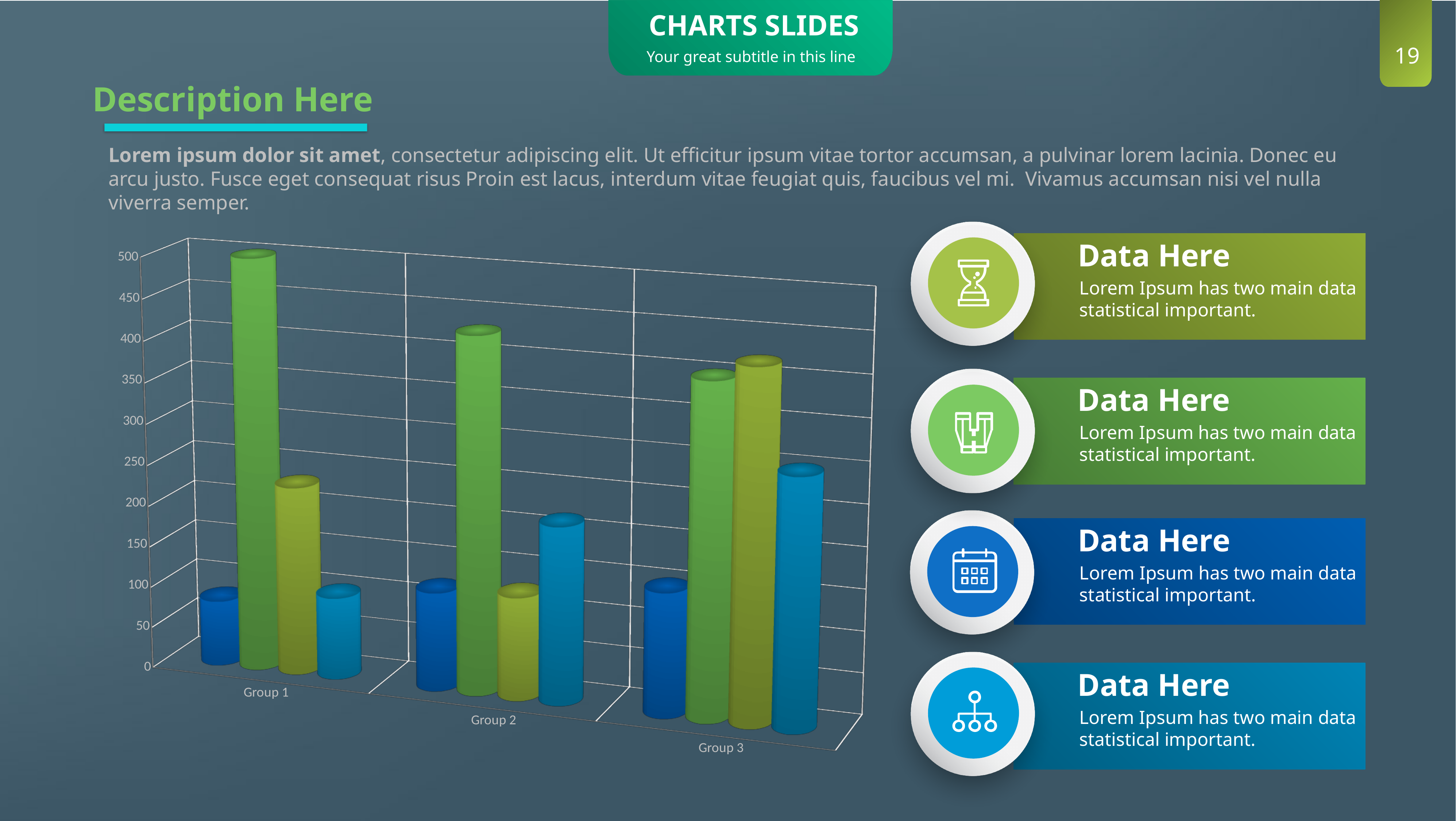
In Group 3, which is larger: the light blue bar or the dark blue bar? the light blue bar How many groups (categories) are shown on the x axis of the chart? 3 Is the value of the light blue bar for Group 3 greater or less than 150? greater Is the value of the green bar for Group 1 greater or less than 400? greater Which group has the tallest green bar? Group 1 What is the highest value shown on the vertical axis of the chart? 500 What kind of chart is shown on the slide? bar chart Is the value of the dark blue bar for Group 1 greater or less than 150? less In Group 1, which is larger: the green bar or the olive bar? the green bar Do the values of the green bars rise or fall from Group 1 to Group 3? fall How many bars are plotted for each group in the chart? 4